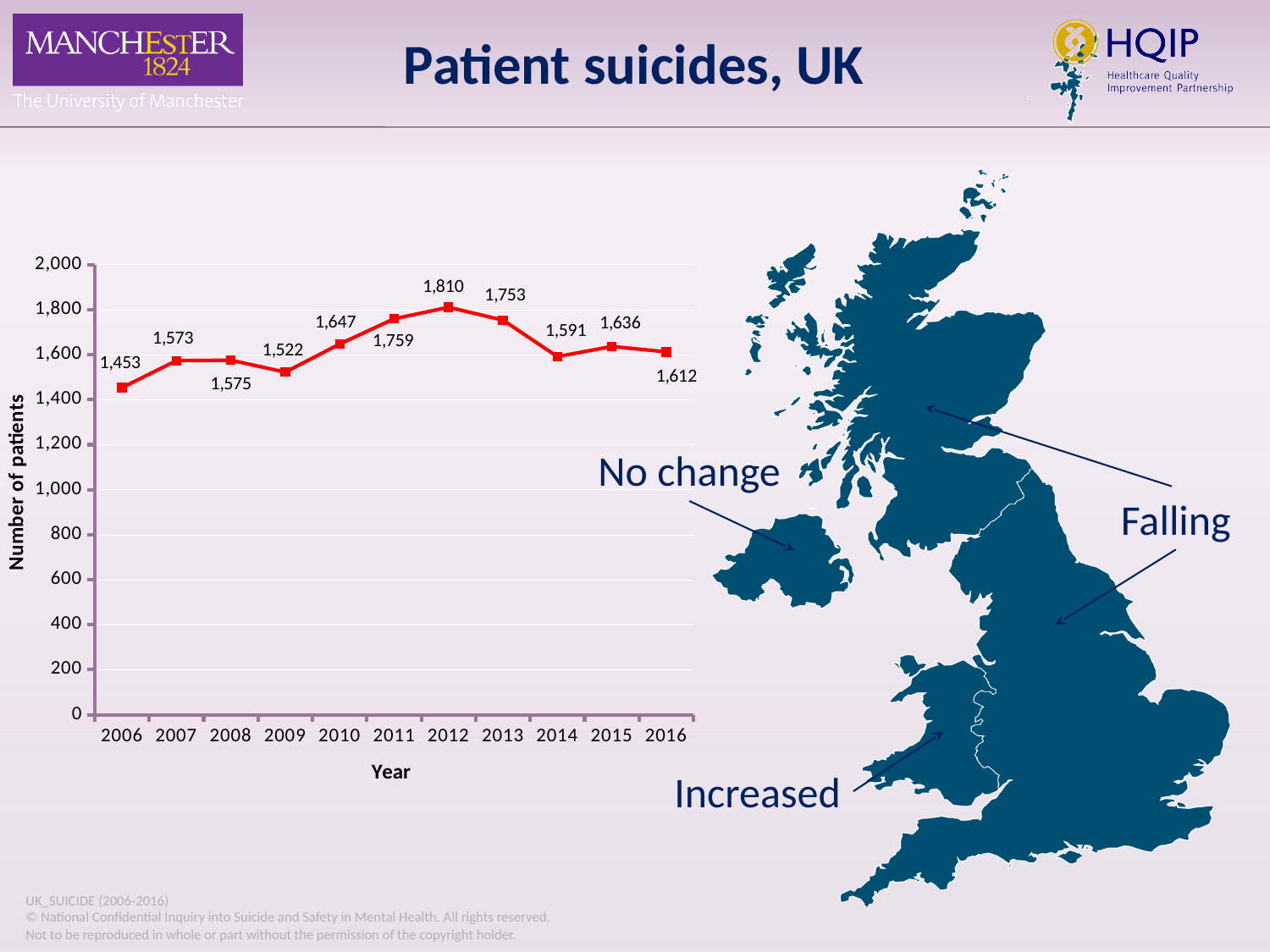
Which year has the lowest number of patients? 2006 Which year has the highest number of patients? 2012 Does the number of patients rise or fall from 2012 to 2014? Fall Which year has a higher number of patients, 2011 or 2014? 2011 What is the number of patients in 2016? 1,612 How many years are plotted on the x axis? 11 What is the label of the y axis? Number of patients What is the difference between the number of patients in 2012 and in 2016? 198 What is the number of patients in 2006? 1,453 What is the number of patients in 2012? 1,810 What type of chart is shown on the slide? Line chart What is the number of patients in 2009? 1,522